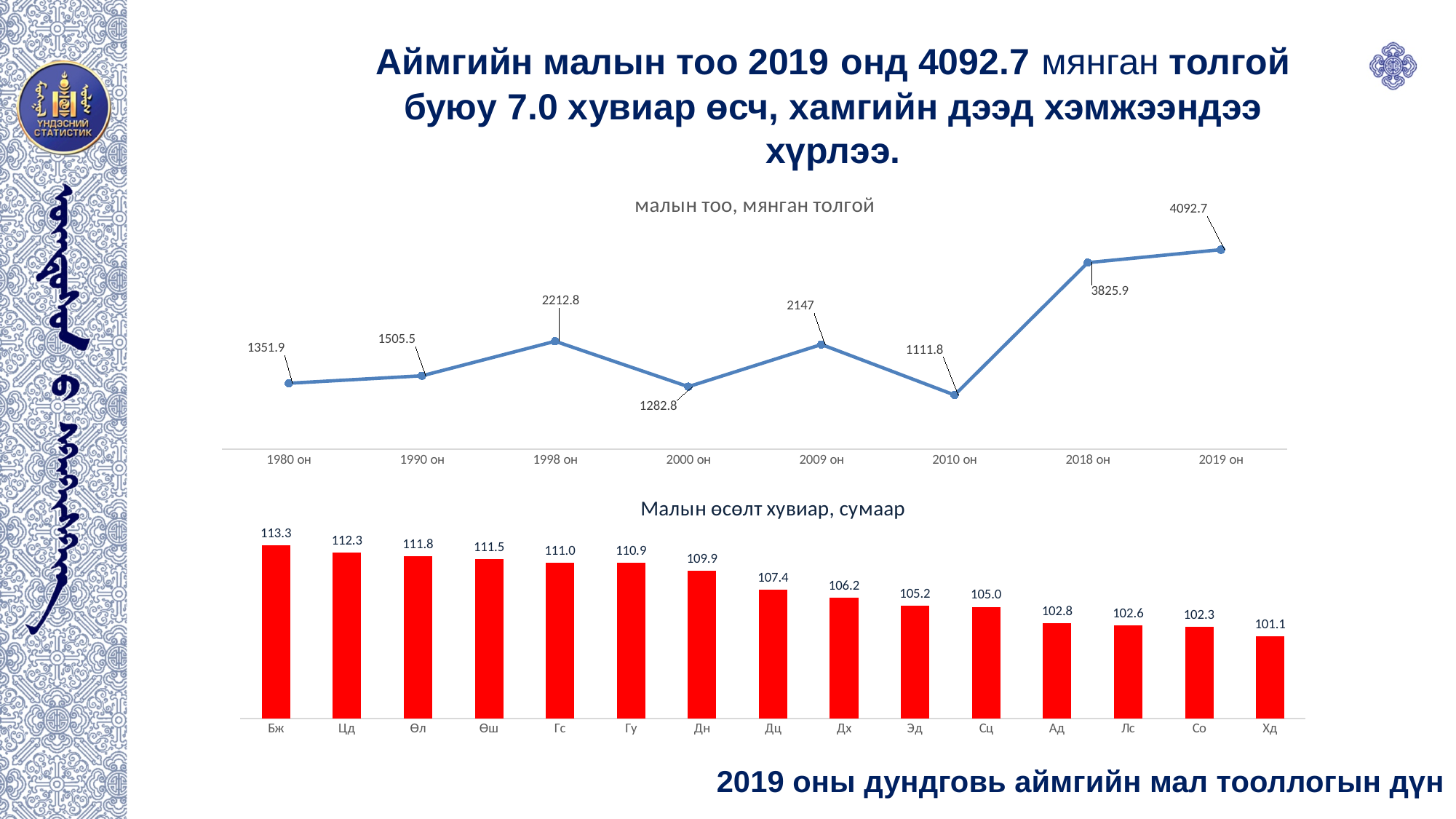
In the bottom chart 'Малын өсөлт хувиар, сумаар', how many categories are shown? 15 In the top chart 'малын тоо, мянган толгой', which year has the lowest value? 2010 он In the bottom chart 'Малын өсөлт хувиар, сумаар', what is the difference between Бж and Хд? 12.2 In the top chart 'малын тоо, мянган толгой', what is the difference between the 2019 он and 2018 он values? 266.8 In the top chart 'малын тоо, мянган толгой', how many data points are plotted? 8 In the bottom chart 'Малын өсөлт хувиар, сумаар', what is the value for Дц? 107.4 What kind of chart is the top chart 'малын тоо, мянган толгой'? line chart In the bottom chart 'Малын өсөлт хувиар, сумаар', which category has the lowest value? Хд In the bottom chart 'Малын өсөлт хувиар, сумаар', which category has the highest value? Бж In the top chart 'малын тоо, мянган толгой', what is the value for 2018 он? 3825.9 What kind of chart is the bottom chart 'Малын өсөлт хувиар, сумаар'? bar chart In the top chart 'малын тоо, мянган толгой', is the value for 1998 он larger or smaller than the value for 2009 он? larger